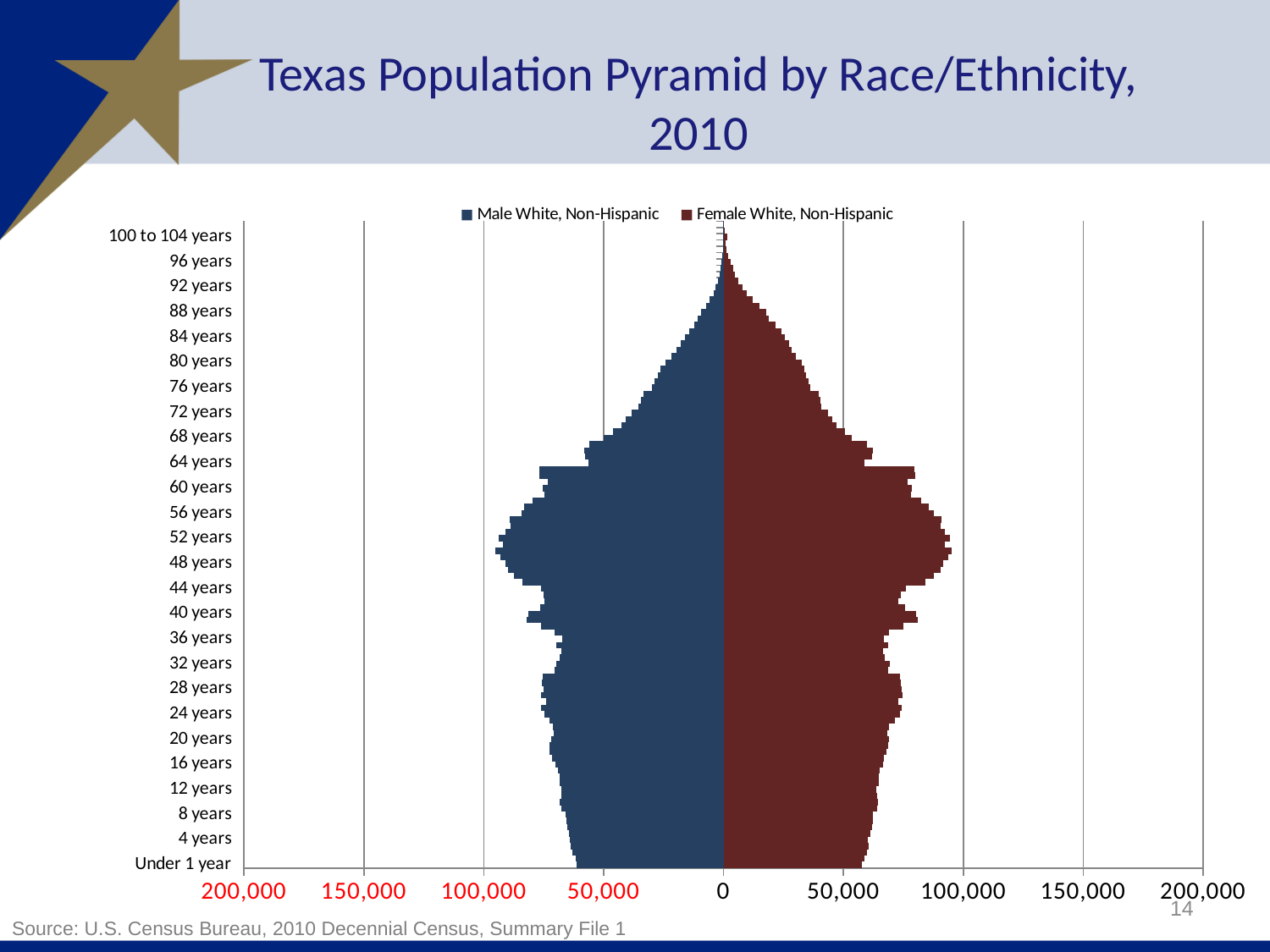
Which is larger for Male White, Non-Hispanic: the value at 52 years or the value at 88 years? 52 years Which is larger for Female White, Non-Hispanic: the value at 48 years or the value at 8 years? 48 years What kind of chart is shown on the slide? Bar chart (population pyramid) What are the two series named in the legend? Male White, Non-Hispanic and Female White, Non-Hispanic What is the title of the chart? Texas Population Pyramid by Race/Ethnicity, 2010 Is the value for Female White, Non-Hispanic at 48 years greater or less than 100,000? less Is the value for Female White, Non-Hispanic at 8 years greater or less than 100,000? less Is the value for Male White, Non-Hispanic at 84 years greater or less than 50,000? less Do the Female White, Non-Hispanic values rise or fall as age increases from 64 years to 100 to 104 years? fall How many series does the legend list? 2